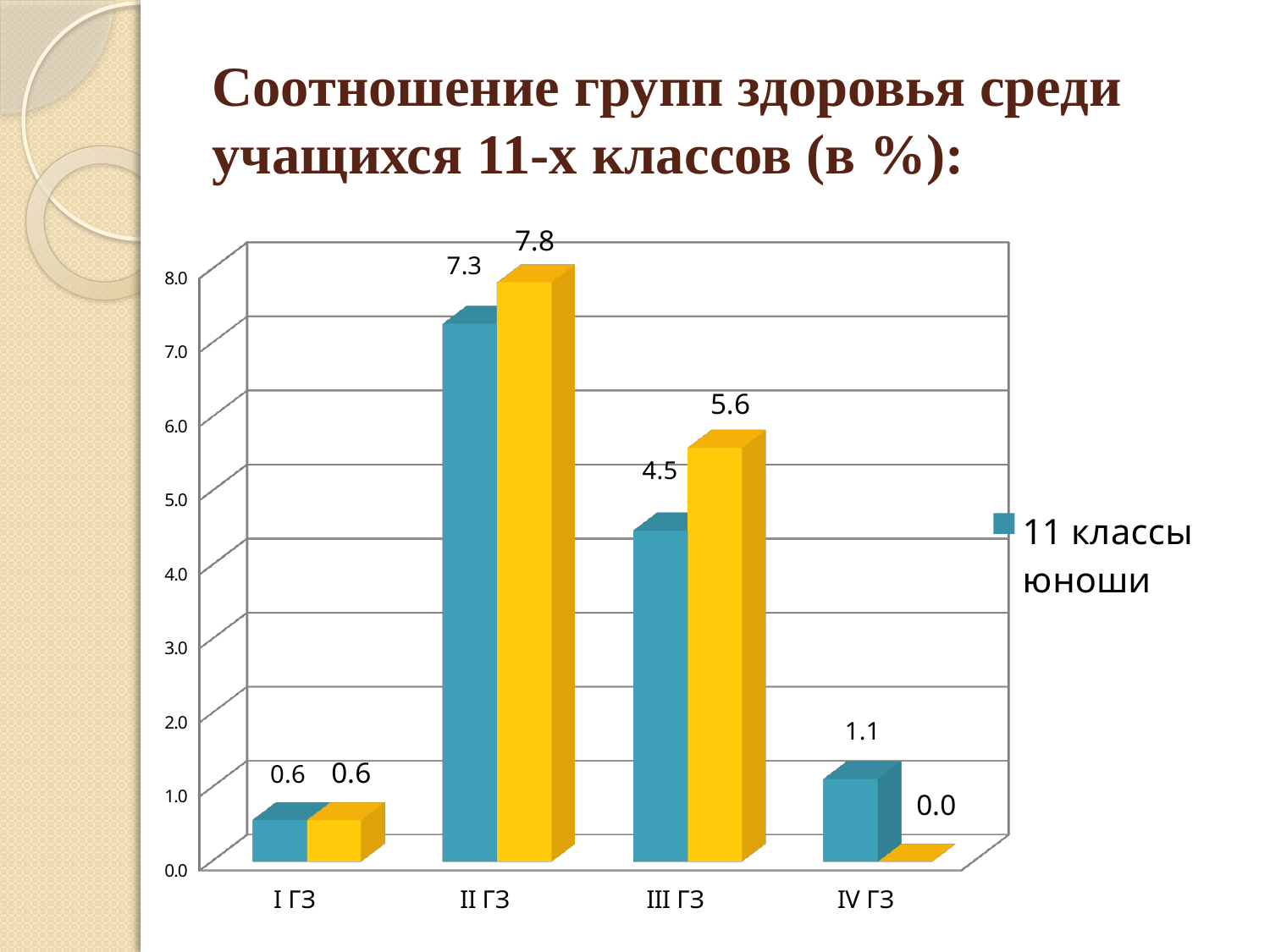
Which category has the highest value for "11 классы юноши"? II ГЗ What type of chart is shown on the slide? bar chart In category III ГЗ, which is larger: the "11 классы юноши" bar or the yellow bar? the yellow bar What is the value for "11 классы юноши" in category IV ГЗ? 1.1 What is the value for "11 классы юноши" in category III ГЗ? 4.5 What is the value of the yellow bar in category IV ГЗ? 0.0 How many categories are shown on the x axis? 4 What is the value of the yellow bar in category III ГЗ? 5.6 What is the value for "11 классы юноши" in category II ГЗ? 7.3 Which category has the lowest value for the yellow series? IV ГЗ What is the difference between the yellow bar and the "11 классы юноши" bar in category II ГЗ? 0.5 What is the title of the slide? Соотношение групп здоровья среди учащихся 11-х классов (в %):